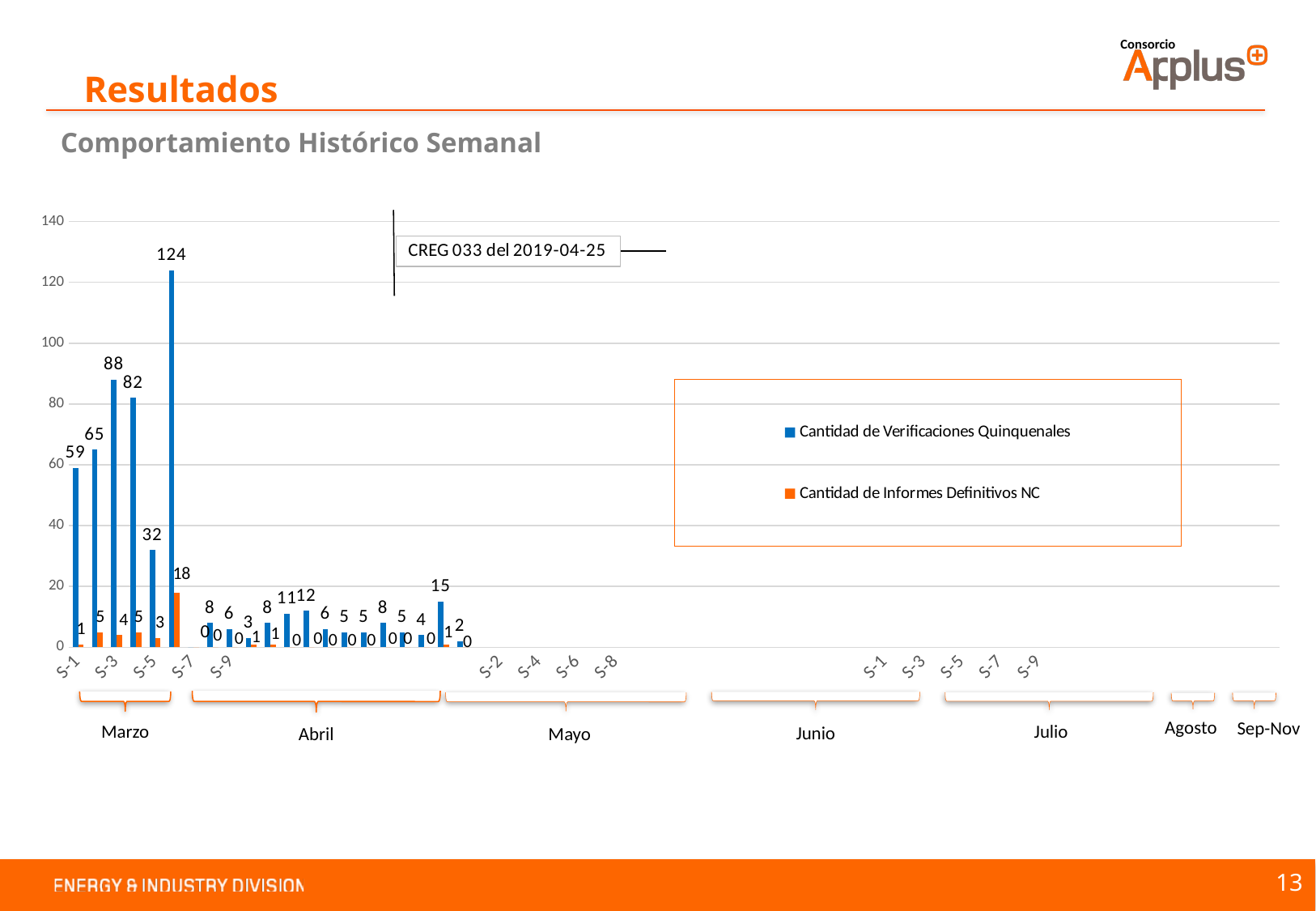
What kind of chart is shown on the slide? bar chart What is the highest value of Cantidad de Informes Definitivos NC shown on the chart? 18 What is the value of Cantidad de Informes Definitivos NC for S-1 in Marzo? 1 How many month groups are labelled below the x axis? 7 What is the difference between the highest Cantidad de Verificaciones Quinquenales value (124) and the second highest (88)? 36 Is the highest Cantidad de Verificaciones Quinquenales bar greater or less than 100? greater What is the value of Cantidad de Verificaciones Quinquenales for S-1 in Marzo? 59 What text appears in the annotation box near the top of the chart? CREG 033 del 2019-04-25 What are the two series named in the chart legend? Cantidad de Verificaciones Quinquenales; Cantidad de Informes Definitivos NC How many series does the chart legend list? 2 What is the highest value of Cantidad de Verificaciones Quinquenales shown on the chart? 124 Which is larger for Cantidad de Verificaciones Quinquenales in Marzo: the first bar (59) or the second bar (65)? 65